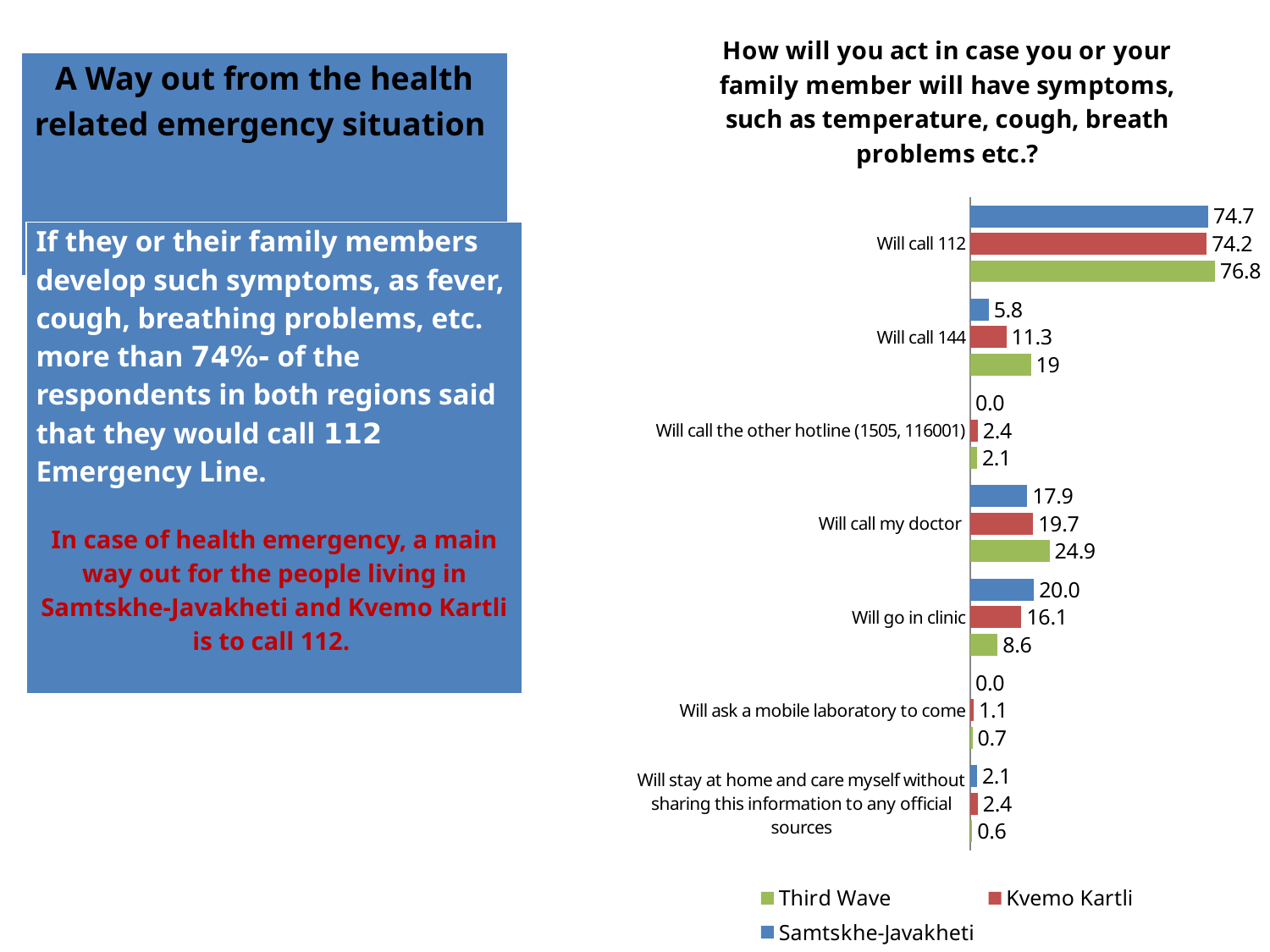
What is the value for 'Will call 144' for Kvemo Kartli? 11.3 Which response category has the lowest value for Third Wave? Will stay at home and care myself without sharing this information to any official sources Which response category has the highest value for Kvemo Kartli? Will call 112 What is the Third Wave value for 'Will call my doctor'? 24.9 Which series is shown in green on the chart? Third Wave How many series does the chart legend list? 3 What is the value for 'Will call 112' for Samtskhe-Javakheti? 74.7 What is the difference between the Kvemo Kartli and Third Wave values for 'Will go in clinic'? 7.5 What kind of chart is shown on the slide? Bar chart For 'Will go in clinic', which is larger: the Samtskhe-Javakheti value or the Third Wave value? Samtskhe-Javakheti How many response categories are shown on the chart? 7 What is the difference between the Third Wave and Samtskhe-Javakheti values for 'Will call 144'? 13.2